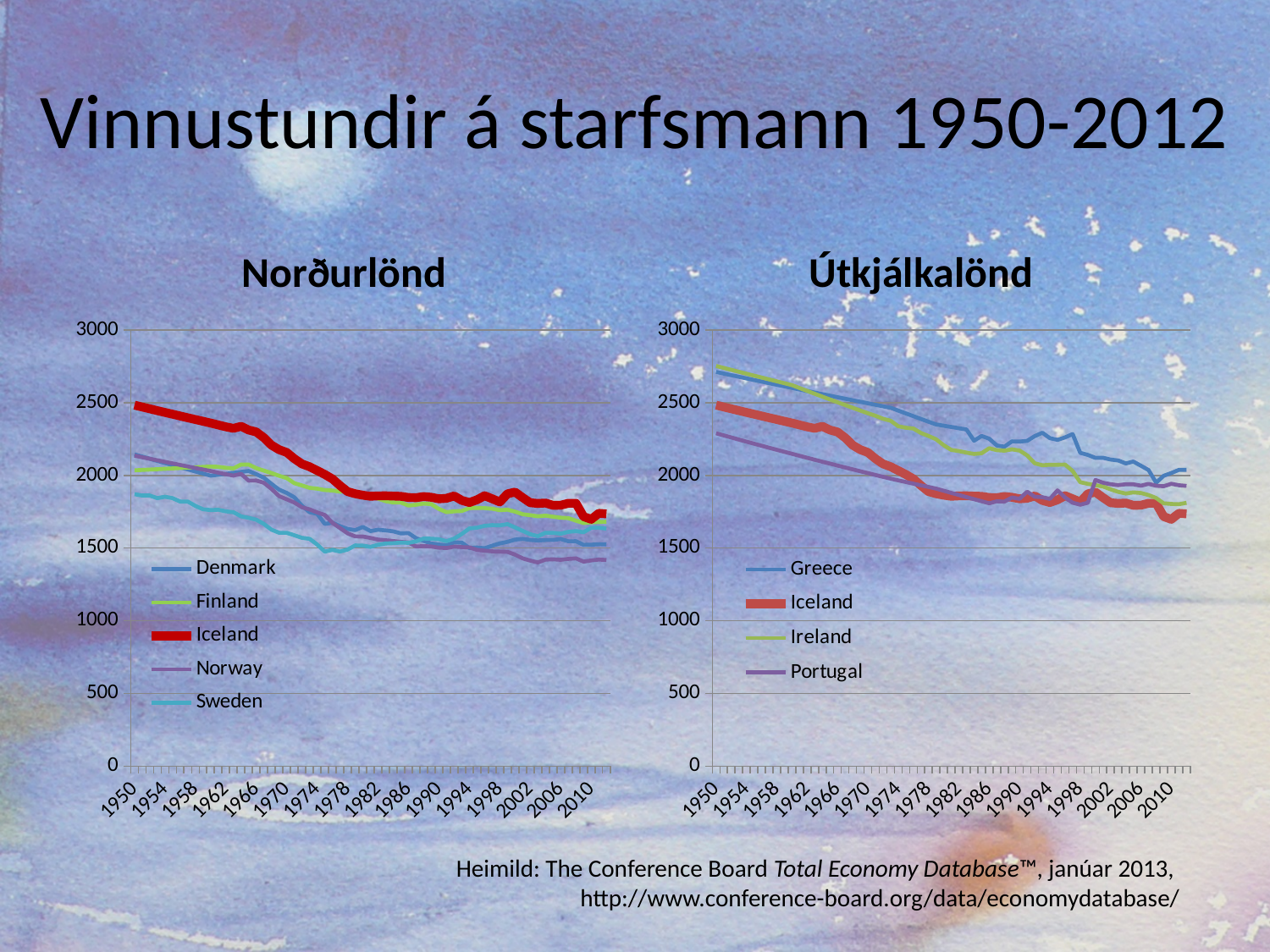
What kind of chart is the Norðurlönd chart? line chart In the Norðurlönd chart, which country has the highest value in 1950? Iceland Which countries are listed in the legend of the Útkjálkalönd chart? Greece, Iceland, Ireland, Portugal In the Útkjálkalönd chart, do the values for Greece rise or fall from 1950 to 2010? fall In the Norðurlönd chart, which country has the lowest value in 1950? Sweden How many series does the legend of the Norðurlönd chart list? 5 In the Útkjálkalönd chart, is the value for Greece in 1950 greater or less than 2500? greater In the Norðurlönd chart, do the values for Iceland rise or fall from 1950 to 2010? fall In the Útkjálkalönd chart, which is larger in 1950, the value for Greece or the value for Portugal? Greece In the Norðurlönd chart, is the value for Iceland in 1950 greater or less than 2000? greater How many series does the legend of the Útkjálkalönd chart list? 4 In the Útkjálkalönd chart, which country has the lowest value in 1950? Portugal